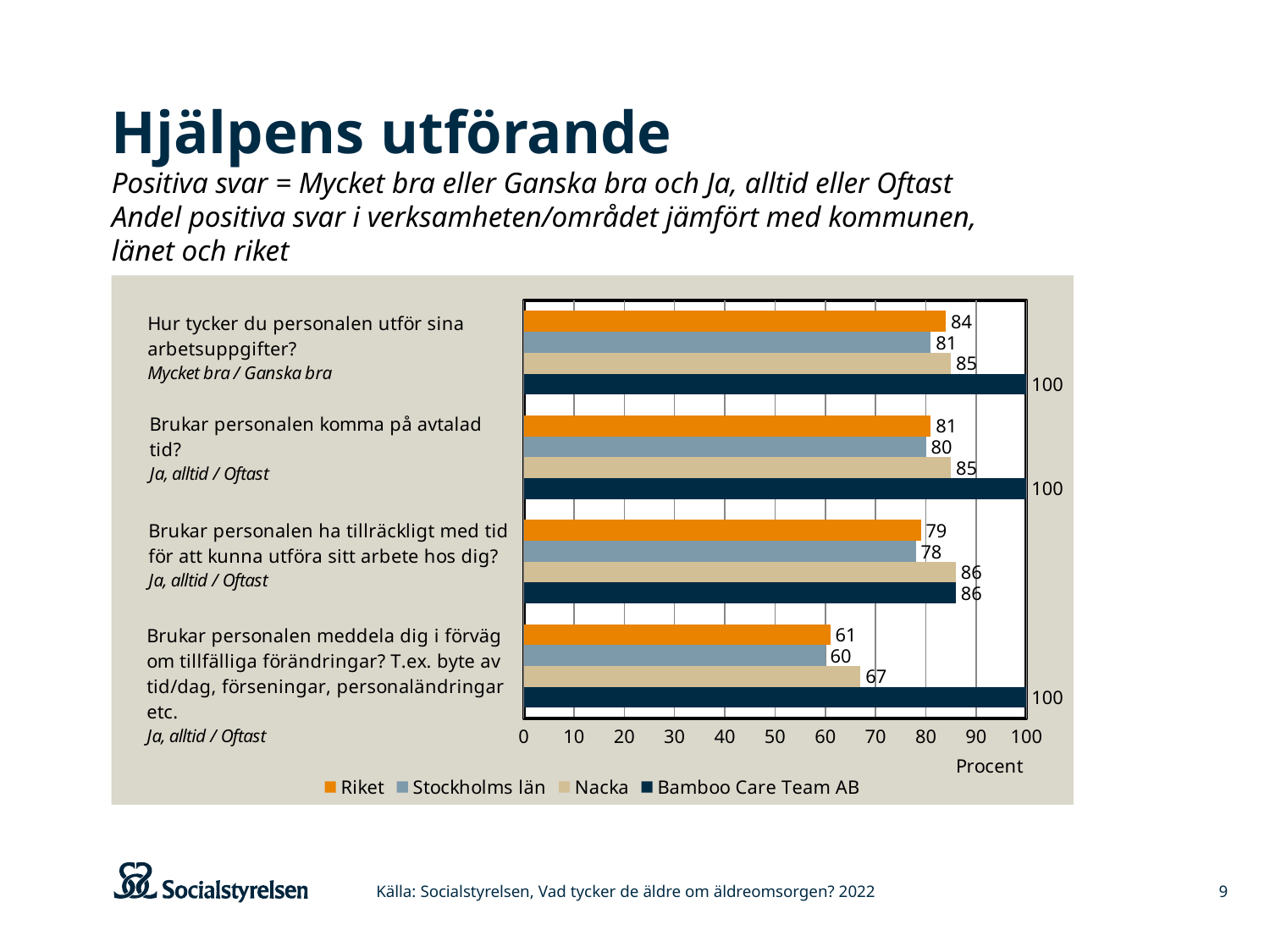
Which is larger on the question "Brukar personalen komma på avtalad tid?": Nacka or Riket? Nacka How many series does the legend list? 4 What is the value for Bamboo Care Team AB on the question "Brukar personalen ha tillräckligt med tid för att kunna utföra sitt arbete hos dig?"? 86 Which series has the lowest value on the question "Brukar personalen ha tillräckligt med tid för att kunna utföra sitt arbete hos dig?"? Stockholms län What is the value for Stockholms län on the question "Brukar personalen meddela dig i förväg om tillfälliga förändringar?"? 60 How many question categories are shown on the chart? 4 What kind of chart is shown on the slide? Bar chart Which series has the highest value on the question "Brukar personalen meddela dig i förväg om tillfälliga förändringar?"? Bamboo Care Team AB What is the value for Riket on the question "Hur tycker du personalen utför sina arbetsuppgifter?"? 84 What is the value for Nacka on the question "Brukar personalen komma på avtalad tid?"? 85 What unit is shown on the horizontal axis of the chart? Procent What is the difference between Nacka and Riket on the question "Brukar personalen meddela dig i förväg om tillfälliga förändringar?"? 6